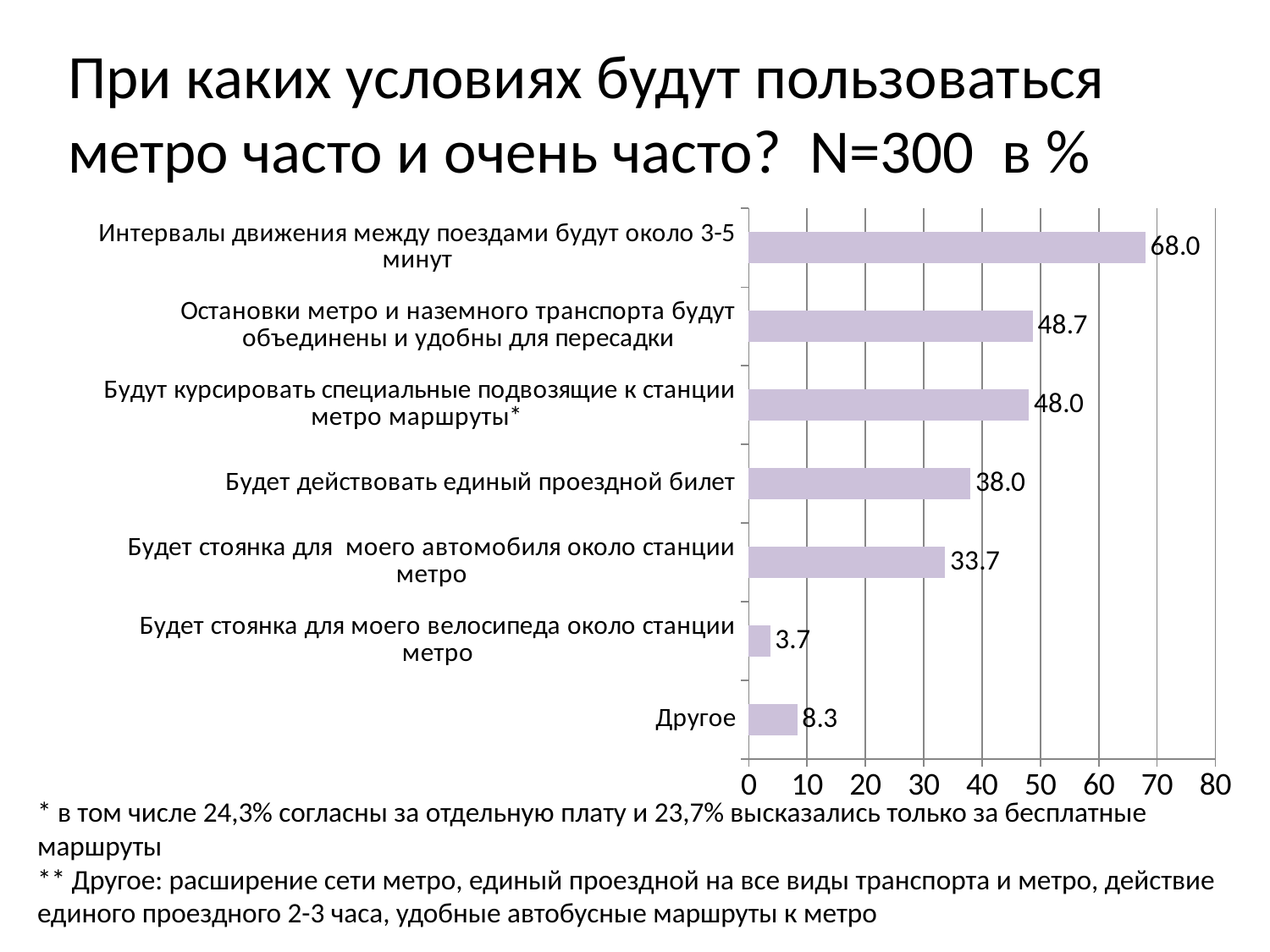
What is the value for "Другое"? 8.3 What kind of chart is shown on the slide? bar chart Is the value for "Будет стоянка для моего автомобиля около станции метро" greater or less than 30? greater Which is larger: the value for "Будет стоянка для моего автомобиля около станции метро" or the value for "Другое"? Будет стоянка для моего автомобиля около станции метро What is the difference between the values for "Остановки метро и наземного транспорта будут объединены и удобны для пересадки" and "Будут курсировать специальные подвозящие к станции метро маршруты*"? 0.7 How many categories are shown in the chart? 7 What is the difference between the values for "Интервалы движения между поездами будут около 3-5 минут" and "Будет действовать единый проездной билет"? 30.0 Which category has the highest value? Интервалы движения между поездами будут около 3-5 минут Which category has the lowest value? Будет стоянка для моего велосипеда около станции метро What is the value for "Будет стоянка для моего велосипеда около станции метро"? 3.7 What is the value for "Будет действовать единый проездной билет"? 38.0 What is the value for "Интервалы движения между поездами будут около 3-5 минут"? 68.0